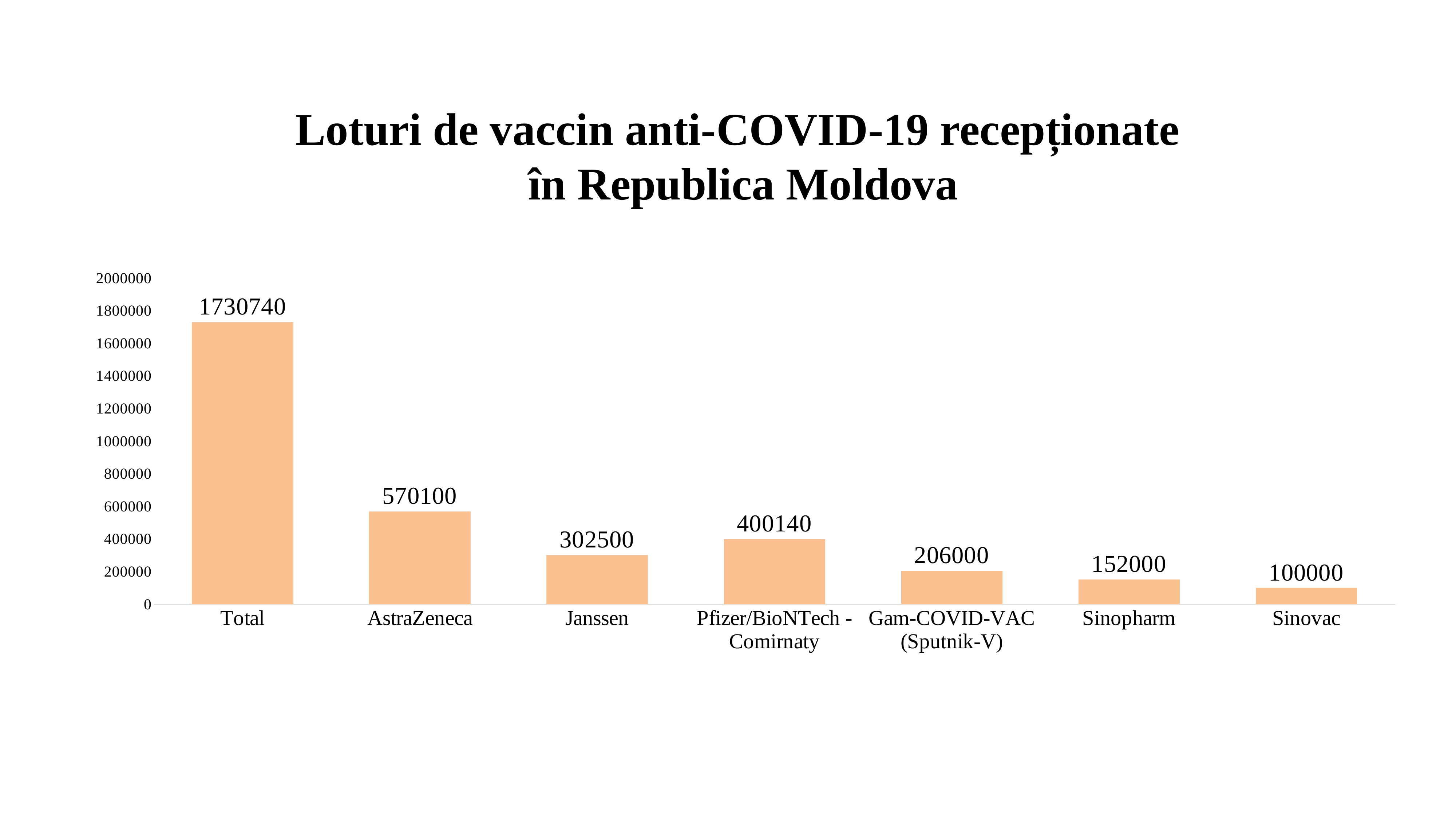
Which vaccine has the lowest value? Sinovac What is the value shown for Pfizer/BioNTech - Comirnaty? 400140 What type of chart is shown on the slide? Bar chart What is the value shown for Gam-COVID-VAC (Sputnik-V)? 206000 What is the value shown for AstraZeneca? 570100 How many bars are shown in the chart? 7 What is the value shown for Janssen? 302500 Which is larger, the value for Pfizer/BioNTech - Comirnaty or the value for Janssen? Pfizer/BioNTech - Comirnaty What is the value shown for the Total bar? 1730740 What is the difference between the values for Sinopharm and Sinovac? 52000 Excluding the Total bar, which vaccine has the highest value? AstraZeneca What is the difference between the values for AstraZeneca and Janssen? 267600